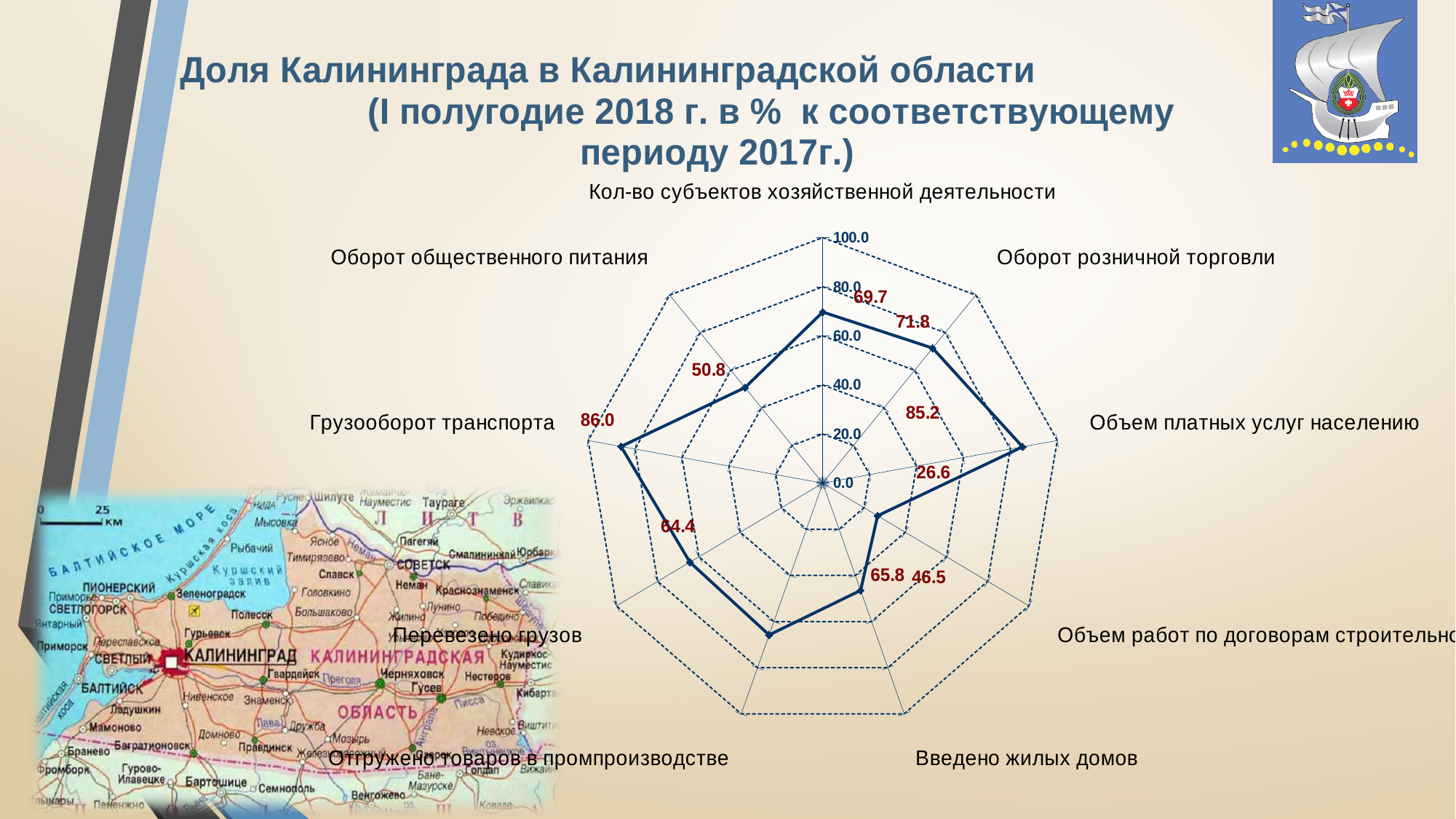
Which is larger: the value for Отгружено товаров в промпроизводстве or the value for Перевезено грузов? Отгружено товаров в промпроизводстве What is the value for Введено жилых домов? 46.5 Which category has the highest value? Грузооборот транспорта What is the maximum value shown on the radar chart's axis scale? 100.0 What is the value for Объем платных услуг населению? 85.2 What is the value for Объем работ по договорам строительного подряда? 26.6 Which category has the lowest value? Объем работ по договорам строительного подряда How many categories (axes) does the radar chart have? 9 What is the difference between the values for Оборот розничной торговли and Кол-во субъектов хозяйственной деятельности? 2.1 What kind of chart is shown on the slide? Radar chart What is the value for Оборот общественного питания? 50.8 What is the value for Грузооборот транспорта? 86.0